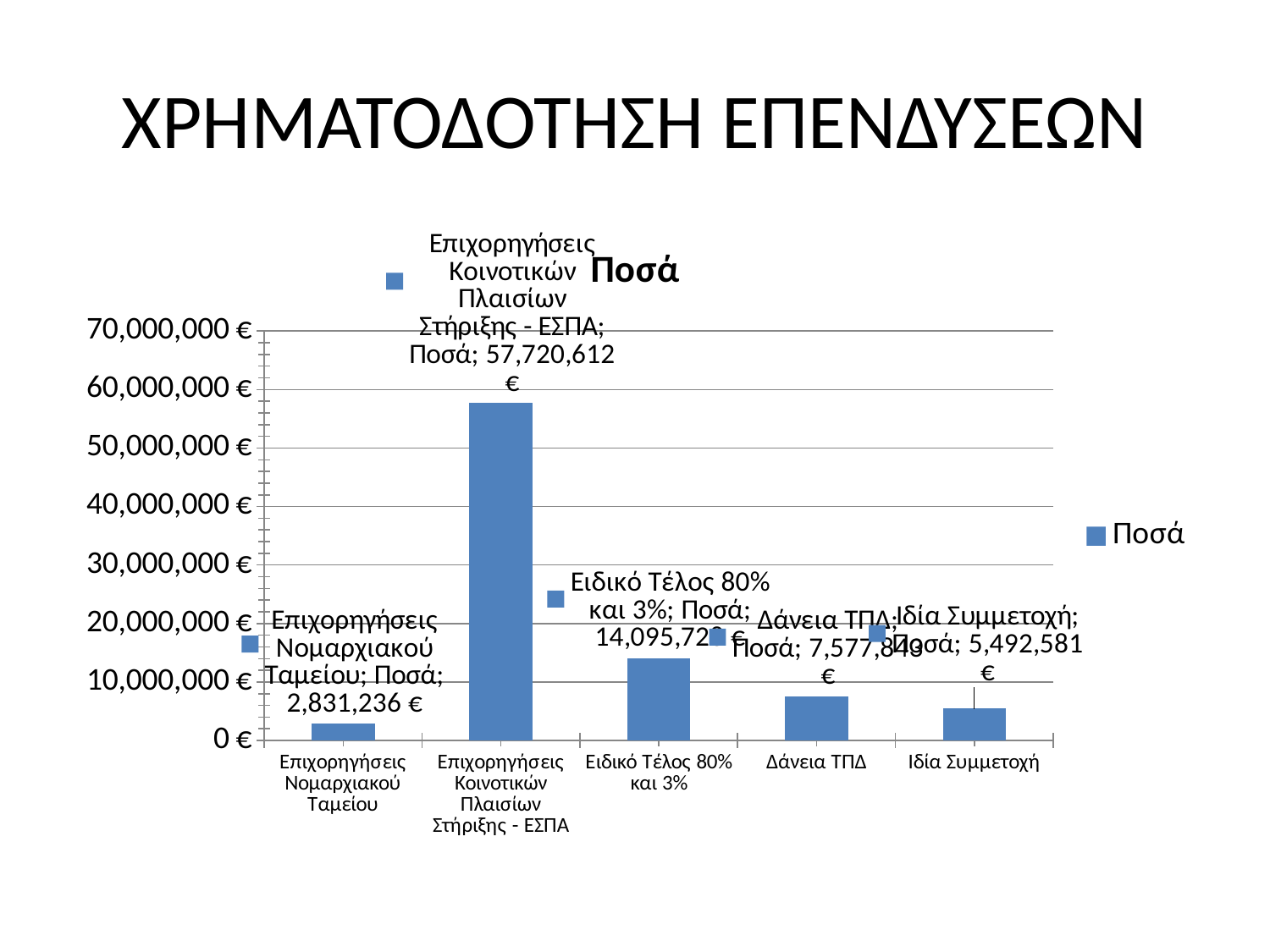
What is the difference between the value for Επιχορηγήσεις Κοινοτικών Πλαισίων Στήριξης - ΕΣΠΑ and the value for Ιδία Συμμετοχή? 52,228,031 € How many categories are shown on the x axis? 5 What is the value for Ιδία Συμμετοχή? 5,492,581 € Which is larger, the value for Δάνεια ΤΠΔ or the value for Ιδία Συμμετοχή? Δάνεια ΤΠΔ What kind of chart is shown on the slide? bar chart What is the difference between the value for Ιδία Συμμετοχή and the value for Επιχορηγήσεις Νομαρχιακού Ταμείου? 2,661,345 € Which category has the lowest value? Επιχορηγήσεις Νομαρχιακού Ταμείου What is the value for Επιχορηγήσεις Νομαρχιακού Ταμείου? 2,831,236 € Is the value for Ειδικό Τέλος 80% και 3% greater or less than 10,000,000 €? greater What is the value for Επιχορηγήσεις Κοινοτικών Πλαισίων Στήριξης - ΕΣΠΑ? 57,720,612 € Which category has the highest value? Επιχορηγήσεις Κοινοτικών Πλαισίων Στήριξης - ΕΣΠΑ How many series does the legend list? 1